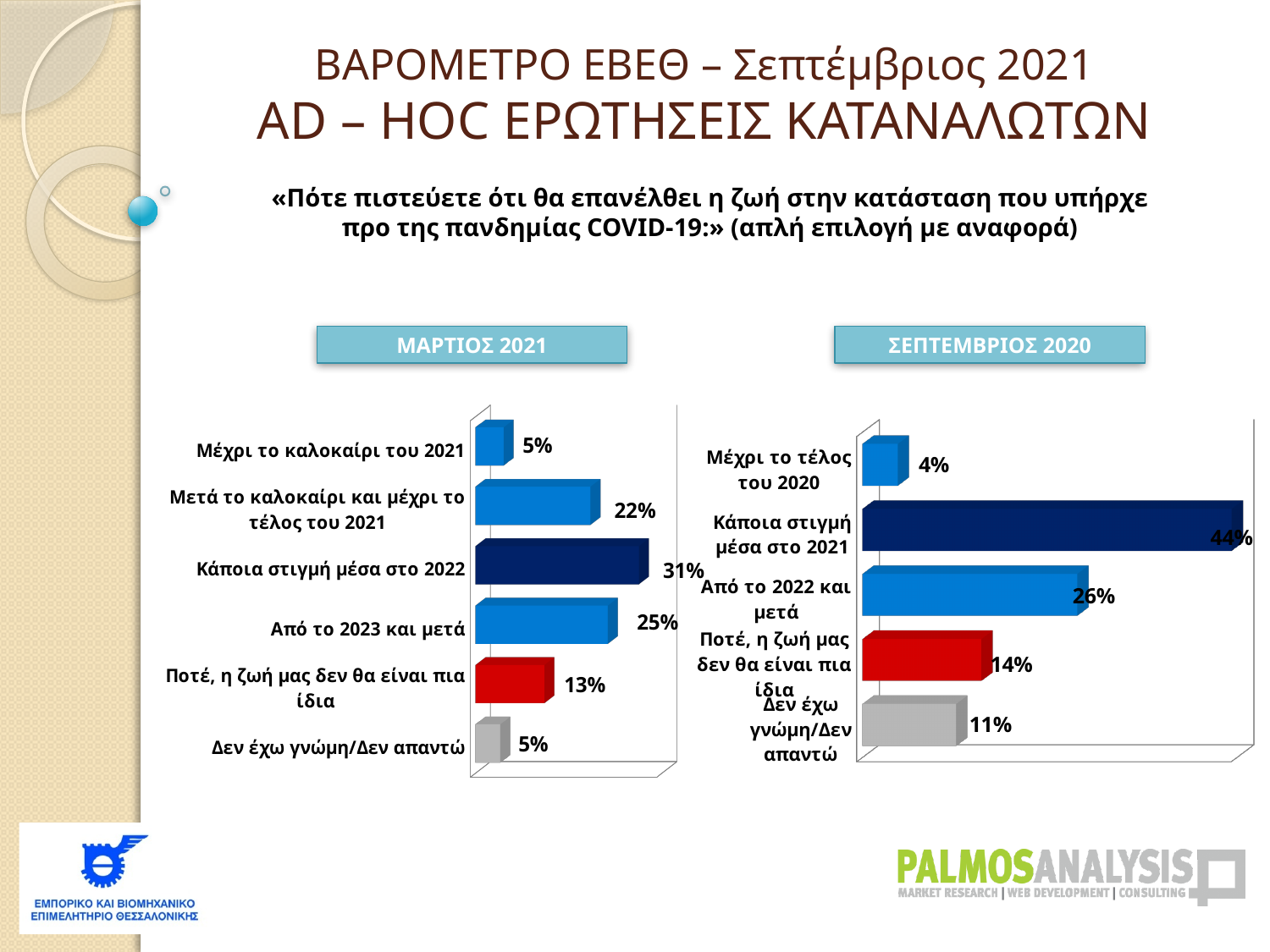
In the ΣΕΠΤΕΜΒΡΙΟΣ 2020 chart, what is the difference between "Κάποια στιγμή μέσα στο 2021" and "Από το 2022 και μετά"? 18% In the ΜΑΡΤΙΟΣ 2021 chart, which is larger: "Από το 2023 και μετά" or "Ποτέ, η ζωή μας δεν θα είναι πια ίδια"? Από το 2023 και μετά In the ΜΑΡΤΙΟΣ 2021 chart, which category has the highest value? Κάποια στιγμή μέσα στο 2022 In the ΜΑΡΤΙΟΣ 2021 chart, what is the value for "Από το 2023 και μετά"? 25% What type of chart is the ΣΕΠΤΕΜΒΡΙΟΣ 2020 chart? Bar chart How many categories does the ΣΕΠΤΕΜΒΡΙΟΣ 2020 chart show? 5 In the ΣΕΠΤΕΜΒΡΙΟΣ 2020 chart, what is the value for "Δεν έχω γνώμη/Δεν απαντώ"? 11% How many categories does the ΜΑΡΤΙΟΣ 2021 chart show? 6 In the ΜΑΡΤΙΟΣ 2021 chart, what is the value for "Κάποια στιγμή μέσα στο 2022"? 31% In the ΣΕΠΤΕΜΒΡΙΟΣ 2020 chart, what is the value for "Κάποια στιγμή μέσα στο 2021"? 44% In the ΜΑΡΤΙΟΣ 2021 chart, what is the difference between "Κάποια στιγμή μέσα στο 2022" and "Μετά το καλοκαίρι και μέχρι το τέλος του 2021"? 9% In the ΣΕΠΤΕΜΒΡΙΟΣ 2020 chart, which category has the lowest value? Μέχρι το τέλος του 2020